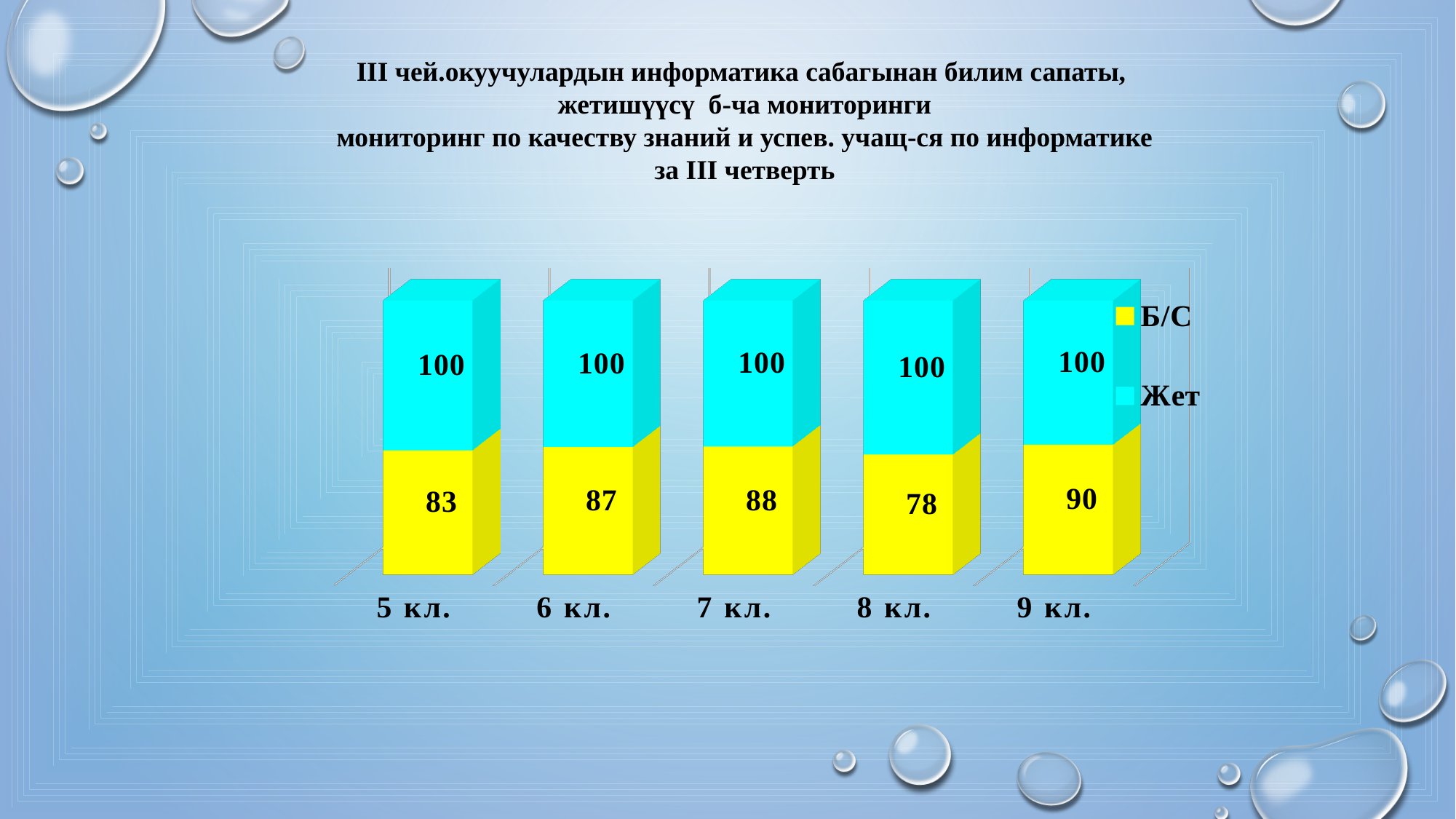
What kind of chart is shown on the slide? Stacked bar chart How many series does the legend list? 2 What is the difference between the Б/С values for 9 кл. and 8 кл.? 12 What is the Б/С value for 9 кл.? 90 How many classes are shown on the x axis? 5 Which colour represents the Жет series in the legend? Cyan What is the Б/С value for 5 кл.? 83 Which has a larger Б/С value, 6 кл. or 7 кл.? 7 кл. Which class has the highest Б/С value? 9 кл. What is the Б/С value for 8 кл.? 78 What is the Жет value for 7 кл.? 100 Which class has the lowest Б/С value? 8 кл.